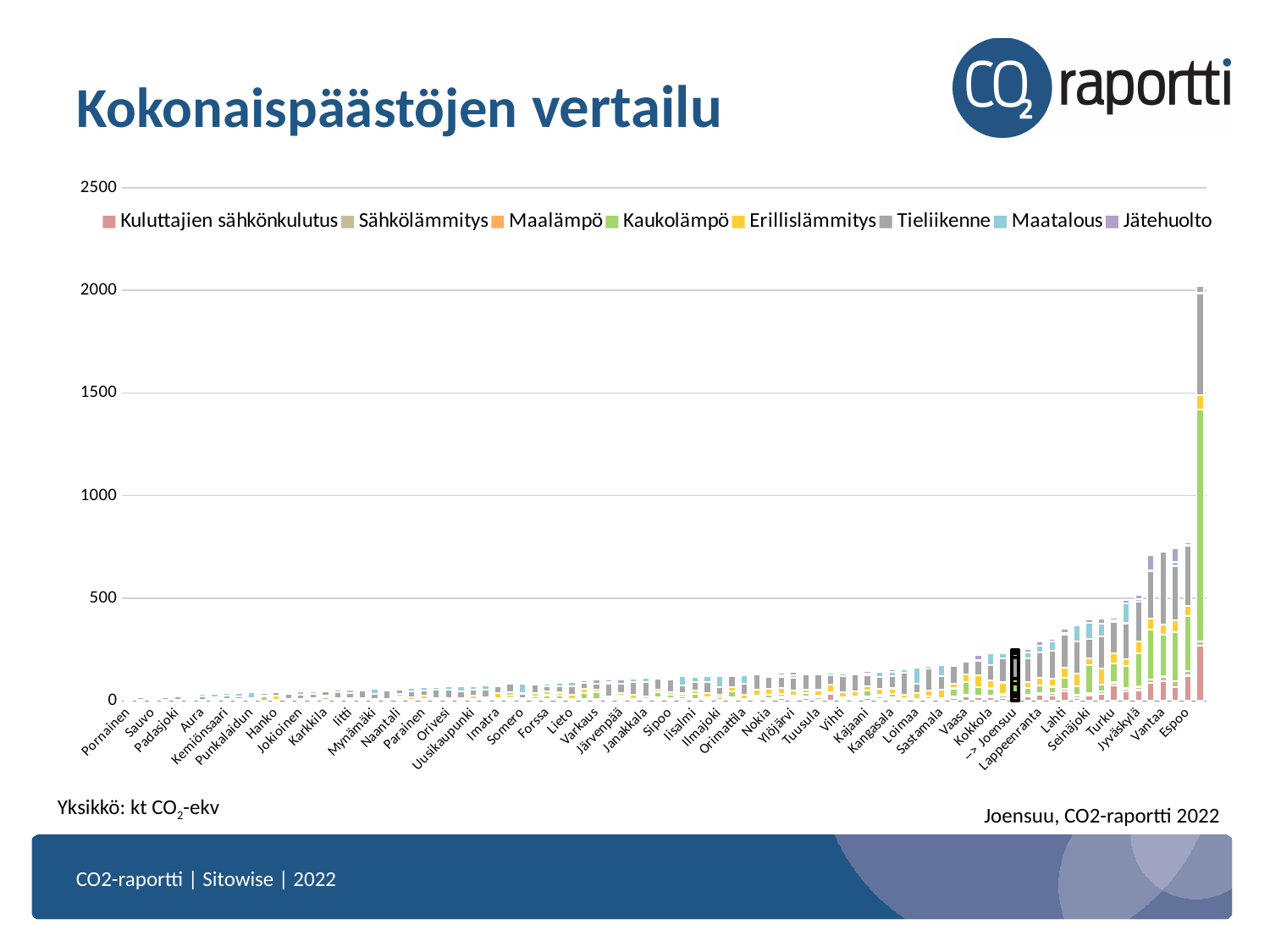
How many series does the legend list? 8 Is the total value for Joensuu greater or less than 500? less What kind of chart is shown on the slide? Stacked bar chart Is the total value for Espoo greater or less than 1500? less What is the title of the chart? Kokonaispäästöjen vertailu Which has a larger total, Espoo or Vantaa? Espoo Do the bar totals generally rise or fall from left to right along the x axis? Rise Is the total value for Vantaa greater or less than 1000? less Which municipality has the lowest total emissions in the chart? Pornainen Which has a larger total, Turku or Lahti? Turku